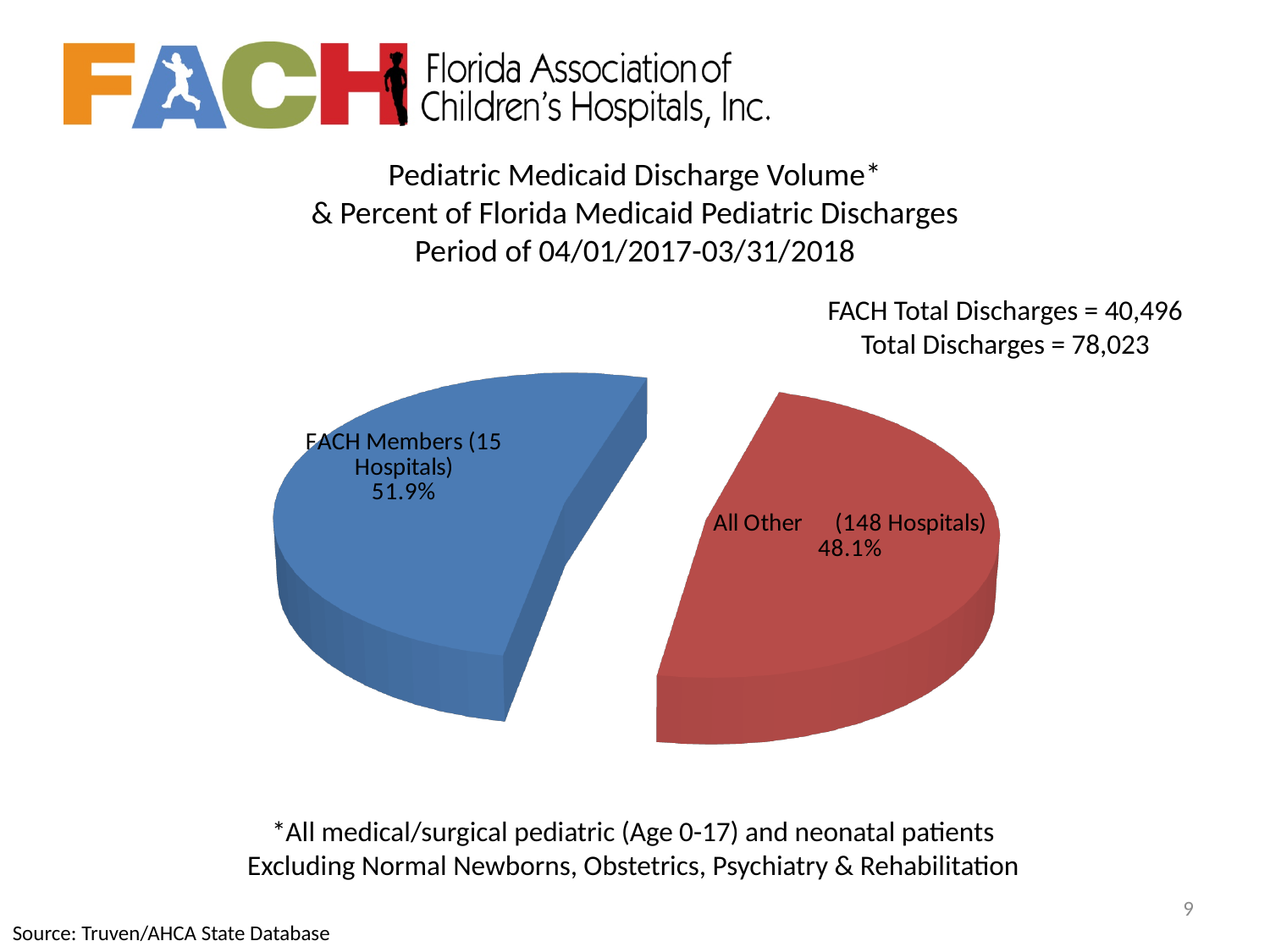
What colour is the FACH Members slice of the pie? Blue What share of the pie does the All Other (148 Hospitals) slice represent? 48.1% Which category has the largest share of the pie? FACH Members (15 Hospitals) What is the FACH Total Discharges figure stated on the slide? 40,496 What share of the pie does the FACH Members (15 Hospitals) slice represent? 51.9% How many hospitals are included in the All Other slice? 148 Which category has the smallest share of the pie? All Other (148 Hospitals) How many slices does the pie chart have? 2 What is the Total Discharges figure stated on the slide? 78,023 What is the difference in percentage points between the FACH Members share and the All Other share? 3.8 percentage points Which slice of the pie is larger, FACH Members or All Other? FACH Members What kind of chart is shown on the slide? Pie chart